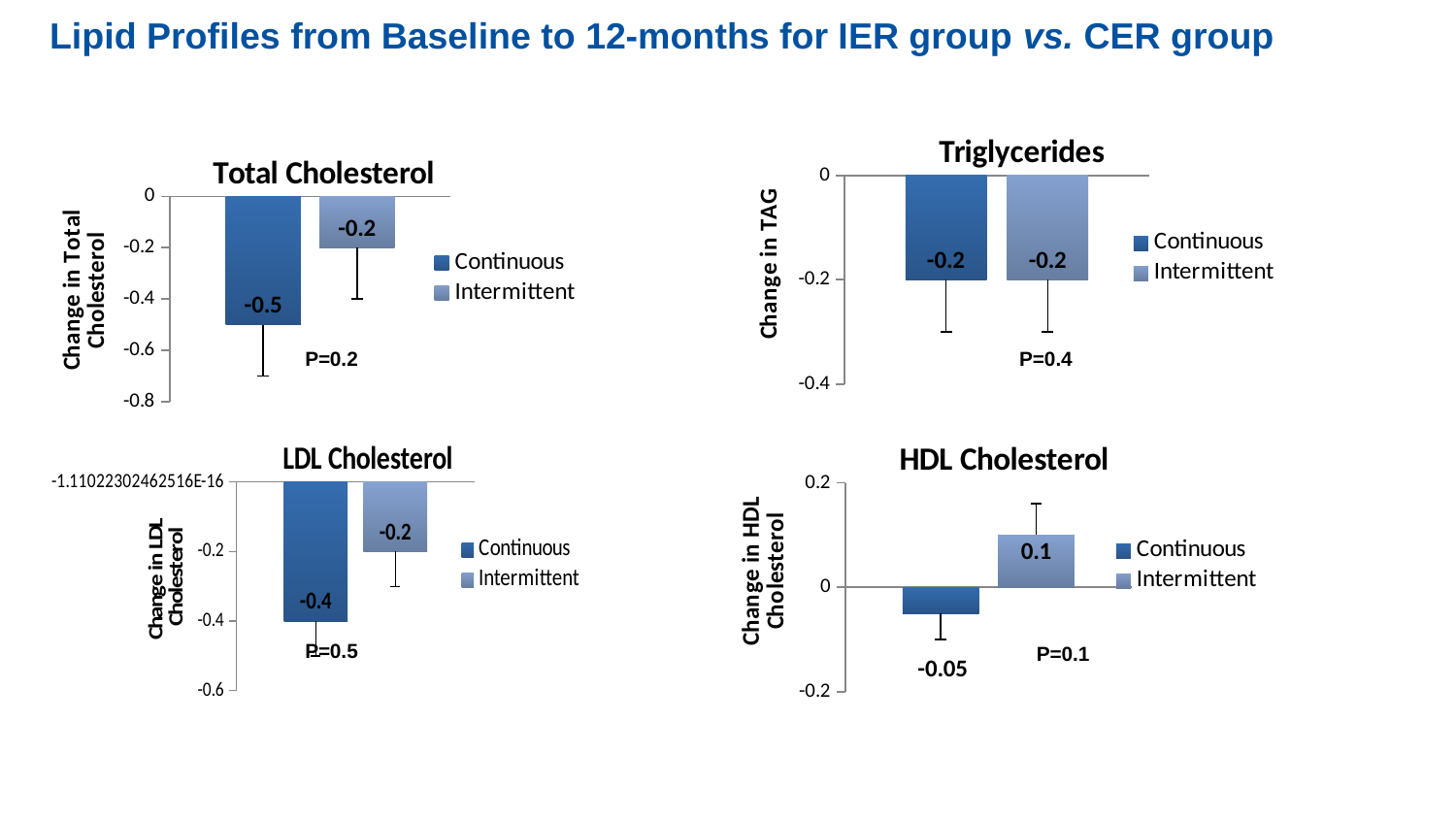
What P value is shown on the Triglycerides chart? P=0.4 In the HDL Cholesterol chart, what is the value for the Continuous group? -0.05 In the Total Cholesterol chart, what is the difference between the Continuous and Intermittent values? 0.3 How many series does the legend of the Triglycerides chart list? 2 In the Triglycerides chart, what is the value for the Intermittent group? -0.2 In the LDL Cholesterol chart, which group shows the larger decrease, Continuous or Intermittent? Continuous In the HDL Cholesterol chart, what is the value for the Intermittent group? 0.1 What kind of chart is the HDL Cholesterol chart? Bar chart In the HDL Cholesterol chart, which group has the higher value, Continuous or Intermittent? Intermittent In the Total Cholesterol chart, what is the value for the Continuous group? -0.5 In the Total Cholesterol chart, what is the value for the Intermittent group? -0.2 In the LDL Cholesterol chart, what is the value for the Continuous group? -0.4